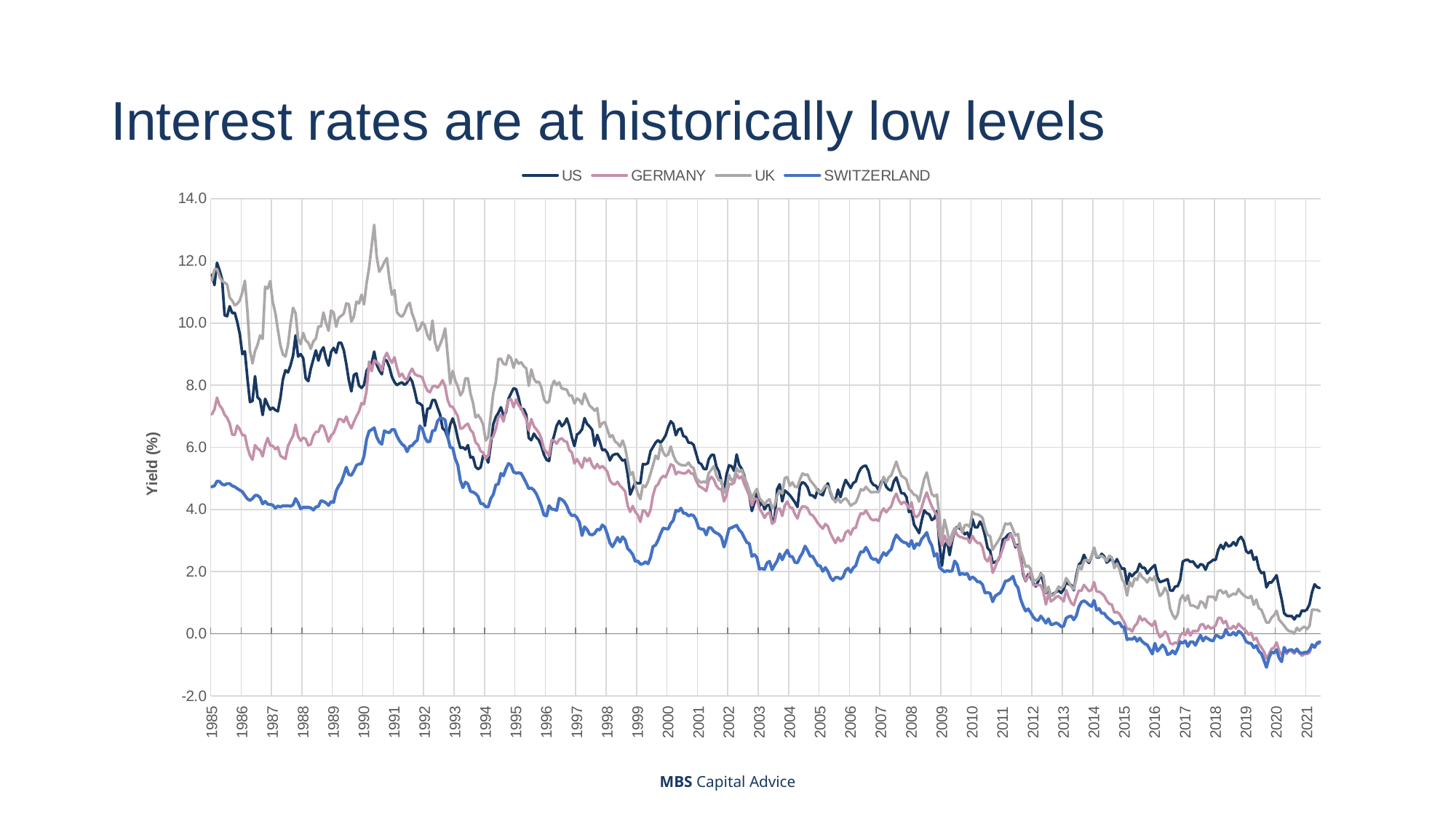
What is the label on the vertical axis of the chart? Yield (%) What kind of chart is shown on the slide? line chart Is the peak value for UK around 1990 greater or less than 12.0? greater Is the value for SWITZERLAND in 2016 greater or less than 0.0? less How many series does the legend list? 4 Is the value for SWITZERLAND in 1985 greater or less than 6.0? less In 1985, which is higher: the US yield or the SWITZERLAND yield? US Do the yields generally rise or fall from 1985 to 2021? fall Which series reaches the highest value anywhere on the chart? UK Which series has the highest value at the end of the chart in 2021? US What is the title of the chart on the slide? Interest rates are at historically low levels Which series has the lowest value in 1985? SWITZERLAND